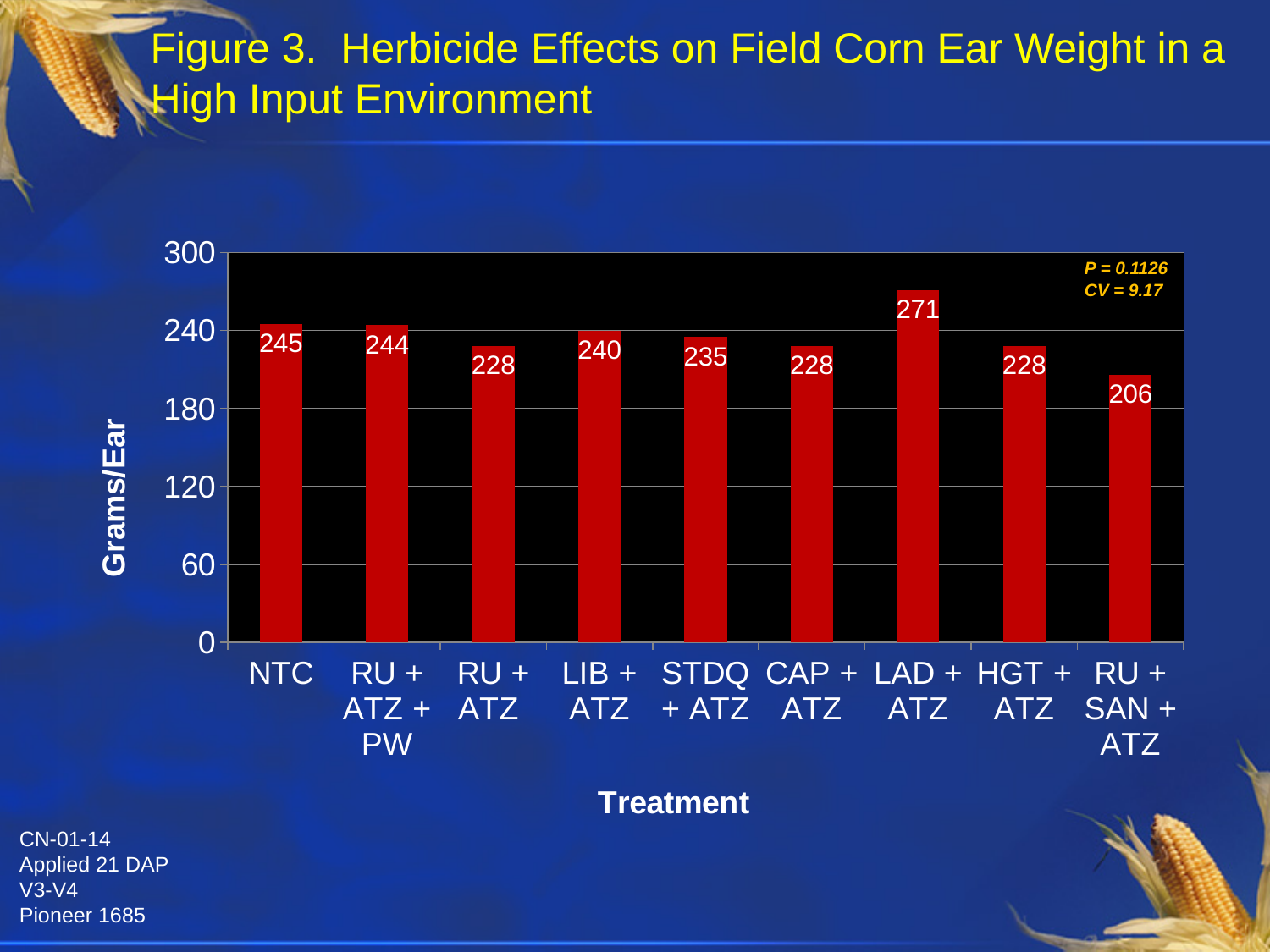
How many treatments are shown on the x axis? 9 What is the ear weight value for the NTC treatment? 245 What is the difference in ear weight between LAD + ATZ and RU + SAN + ATZ? 65 Which treatment has the lowest ear weight? RU + SAN + ATZ What is the label on the y axis of the chart? Grams/Ear Which has a larger ear weight, LIB + ATZ or CAP + ATZ? LIB + ATZ Which treatment has the highest ear weight? LAD + ATZ What is the ear weight value for the LAD + ATZ treatment? 271 What is the difference in ear weight between NTC and STDQ + ATZ? 10 What is the ear weight value for the RU + SAN + ATZ treatment? 206 Is the value for HGT + ATZ greater or less than 240? less What kind of chart is shown on the slide? bar chart